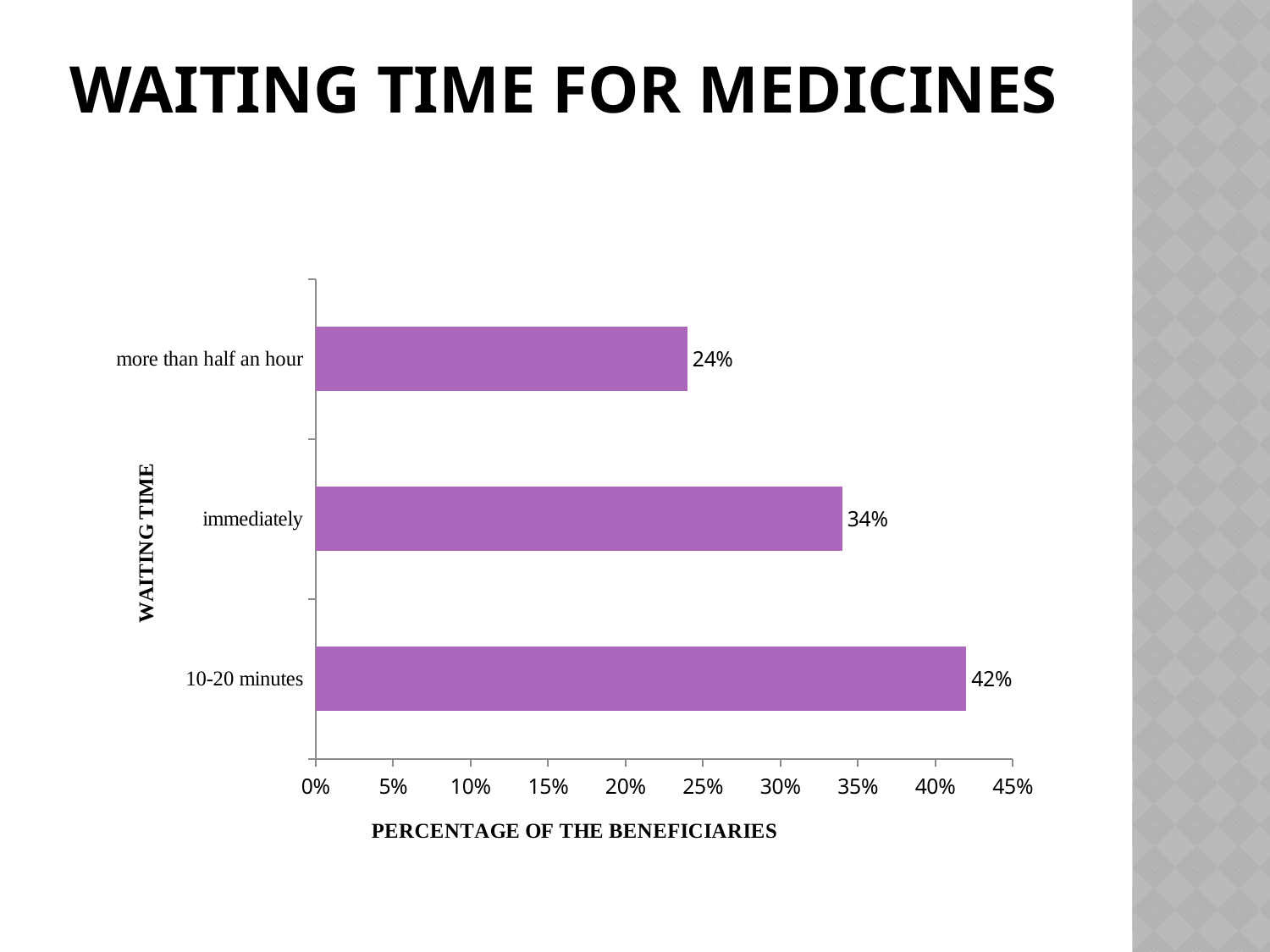
Which is larger: the percentage for immediately or for more than half an hour? immediately What is the difference in percentage points between the 10-20 minutes category and the more than half an hour category? 18% Which waiting time category has the lowest percentage of beneficiaries? more than half an hour Which waiting time category has the highest percentage of beneficiaries? 10-20 minutes What percentage of beneficiaries received medicines immediately? 34% What is the label of the horizontal axis of the chart? PERCENTAGE OF THE BENEFICIARIES What is the difference in percentage points between the immediately category and the more than half an hour category? 10% What kind of chart is shown on the slide? bar chart How many waiting time categories are shown in the chart? 3 Is the value for immediately greater or less than 30%? greater What percentage of beneficiaries waited more than half an hour for medicines? 24% What percentage of beneficiaries waited 10-20 minutes for medicines? 42%